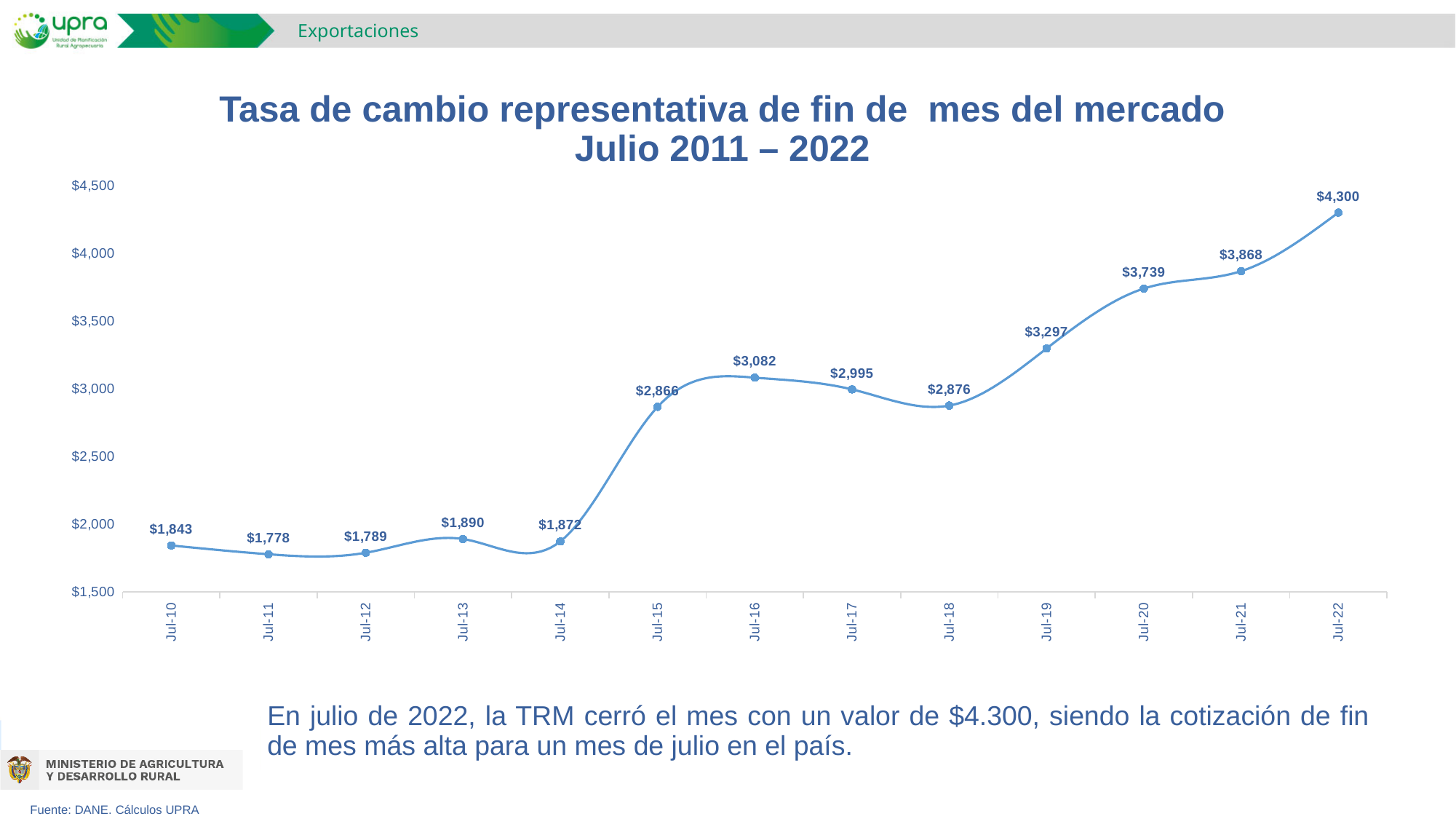
What is the difference between the values for Jul-22 and Jul-21? $432 Which month has the highest value? Jul-22 What is the value for Jul-16? $3,082 What is the difference between the values for Jul-15 and Jul-14? $994 How many data points are plotted on the chart? 13 Is the value for Jul-19 greater or less than $3,000? greater Do the values generally rise or fall from Jul-14 to Jul-22? rise Which month has the lowest value? Jul-11 What is the value for Jul-22? $4,300 What is the value for Jul-11? $1,778 Which is larger, the value for Jul-17 or the value for Jul-18? Jul-17 What kind of chart is shown? line chart